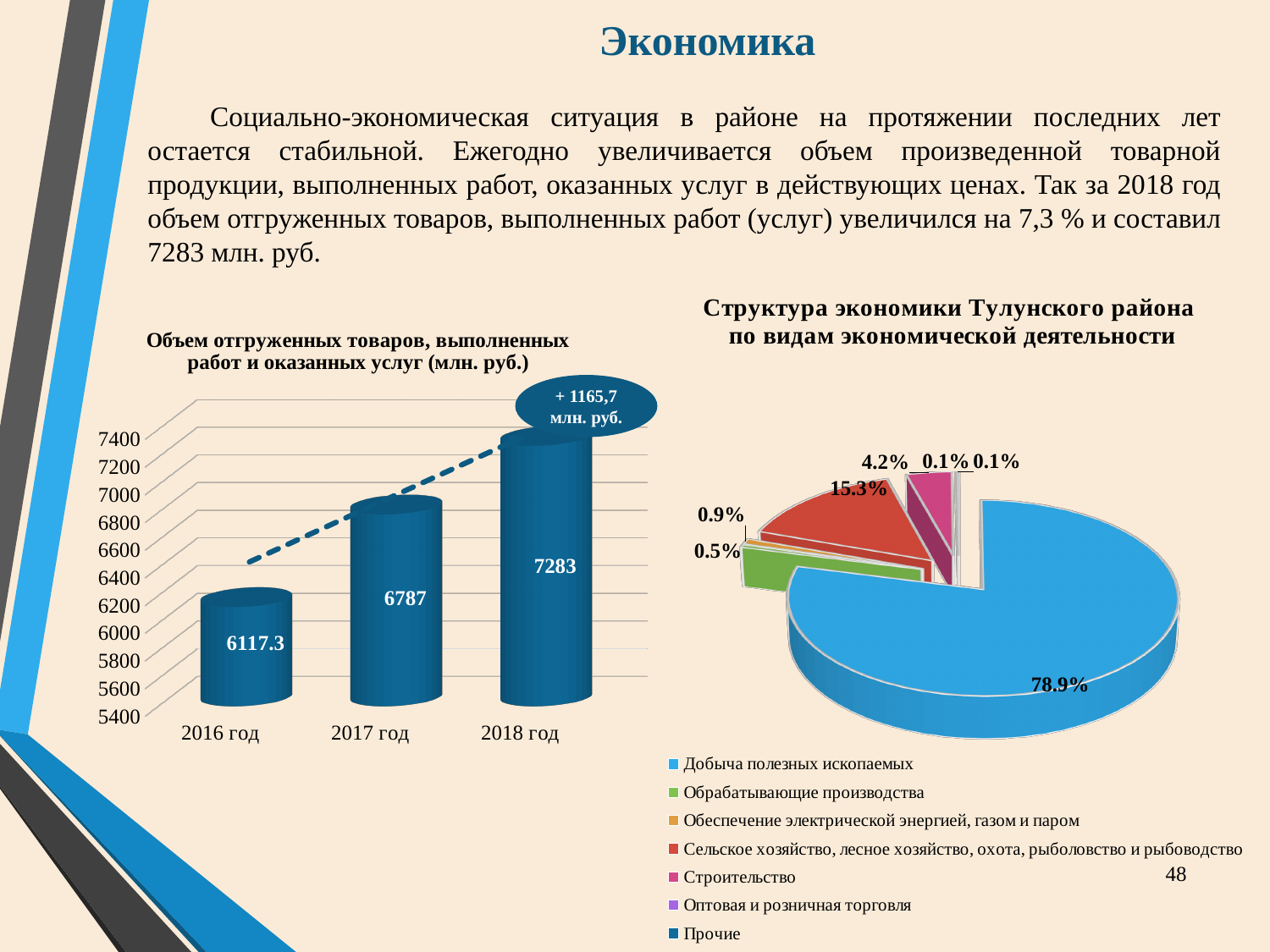
In the bar chart 'Объем отгруженных товаров, выполненных работ и оказанных услуг (млн. руб.)', what is the value for 2017 год? 6787 In the pie chart 'Структура экономики Тулунского района по видам экономической деятельности', which category has the largest slice? Добыча полезных ископаемых In the bar chart 'Объем отгруженных товаров, выполненных работ и оказанных услуг (млн. руб.)', do the values rise or fall from 2016 год to 2018 год? rise In the bar chart 'Объем отгруженных товаров, выполненных работ и оказанных услуг (млн. руб.)', which year has the highest value? 2018 год In the bar chart 'Объем отгруженных товаров, выполненных работ и оказанных услуг (млн. руб.)', which year has the lowest value? 2016 год How many categories does the legend of the pie chart 'Структура экономики Тулунского района по видам экономической деятельности' list? 7 In the bar chart 'Объем отгруженных товаров, выполненных работ и оказанных услуг (млн. руб.)', what is the value for 2016 год? 6117.3 How many years are shown in the bar chart 'Объем отгруженных товаров, выполненных работ и оказанных услуг (млн. руб.)'? 3 In the bar chart 'Объем отгруженных товаров, выполненных работ и оказанных услуг (млн. руб.)', what is the difference between the 2018 год and 2017 год values? 496 What type of chart is the chart on the right of the slide, 'Структура экономики Тулунского района по видам экономической деятельности'? pie chart In the pie chart 'Структура экономики Тулунского района по видам экономической деятельности', what share does Сельское хозяйство, лесное хозяйство, охота, рыболовство и рыбоводство have? 15.3% In the pie chart 'Структура экономики Тулунского района по видам экономической деятельности', what share does Добыча полезных ископаемых have? 78.9%